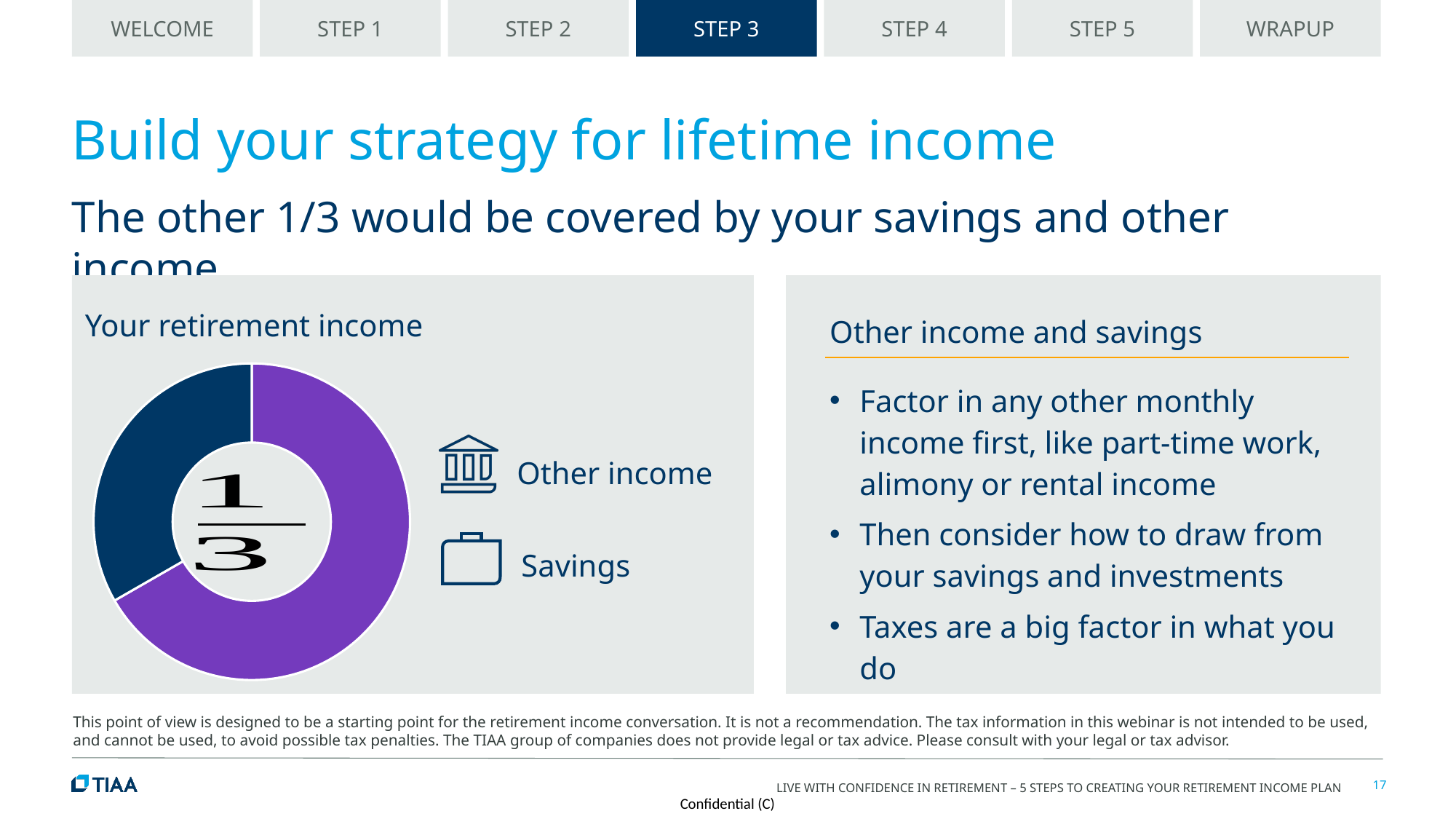
In the "Your retirement income" chart, which slice is the smallest? The dark blue slice What share of the "Your retirement income" chart does the dark blue slice represent? 1/3 In the "Your retirement income" chart, which slice is larger, the purple one or the dark blue one? The purple one What kind of chart is shown under "Your retirement income"? Pie chart (donut) What two colours are used for the slices in the "Your retirement income" chart? Dark blue and purple What fraction is printed in the center of the "Your retirement income" chart? 1/3 What is the title of the chart on the left of the slide? Your retirement income How many slices does the "Your retirement income" chart have? 2